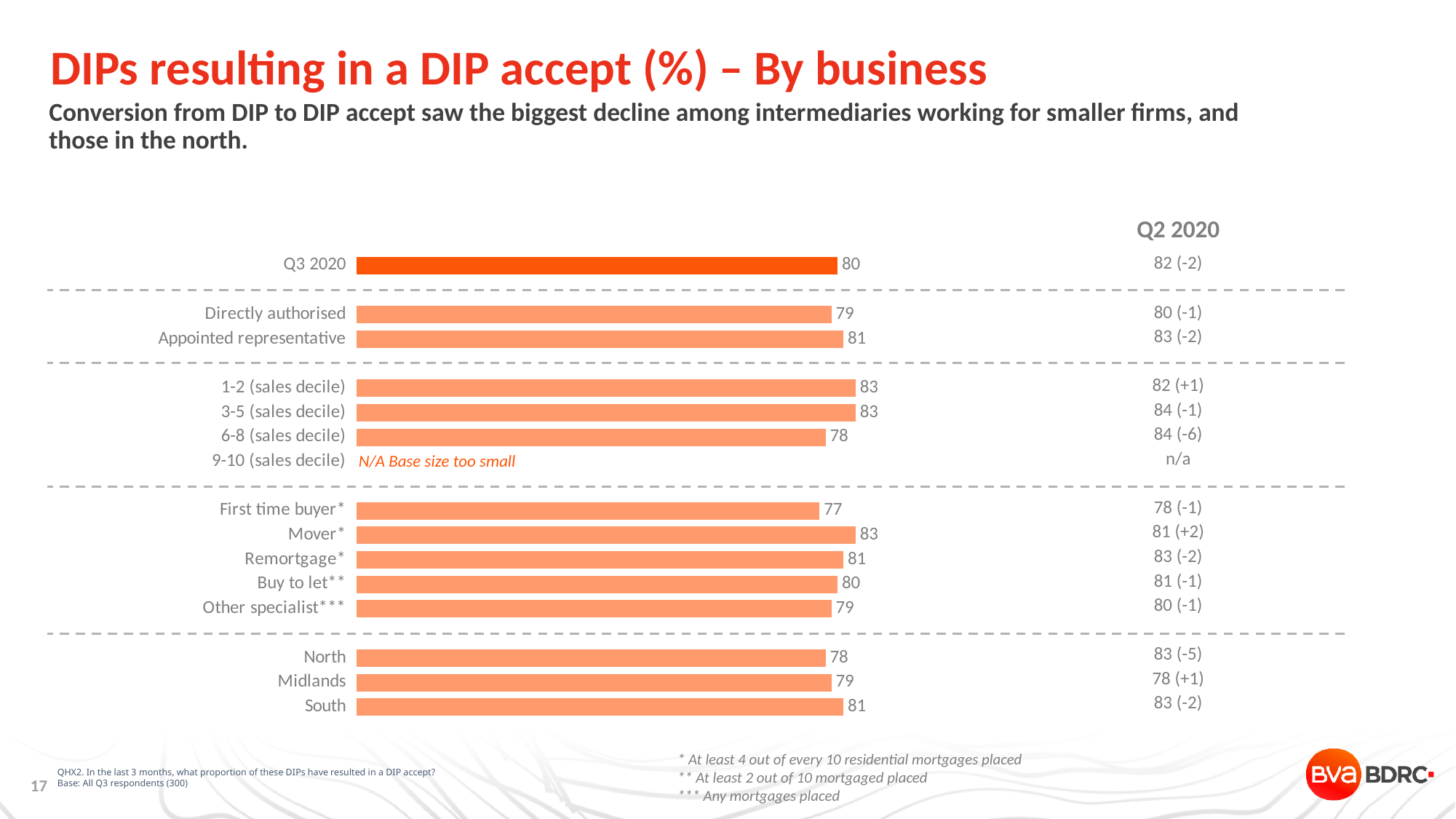
Among the three regions (North, Midlands, South), which has the highest value? South Why is there no bar for 9-10 (sales decile)? N/A Base size too small What is the value for Appointed representative? 81 What is the overall Q3 2020 value shown at the top of the chart? 80 What is the value for First time buyer? 77 What is the difference between the values for Mover and First time buyer? 6 What is the Q2 2020 value shown for 6-8 (sales decile)? 84 (-6) Which category has the lowest value on the chart? First time buyer How many regions are plotted in the bottom group of the chart? 3 What is the value for North? 78 Which is larger, the value for Directly authorised or the value for Appointed representative? Appointed representative What kind of chart is shown on the slide? Bar chart